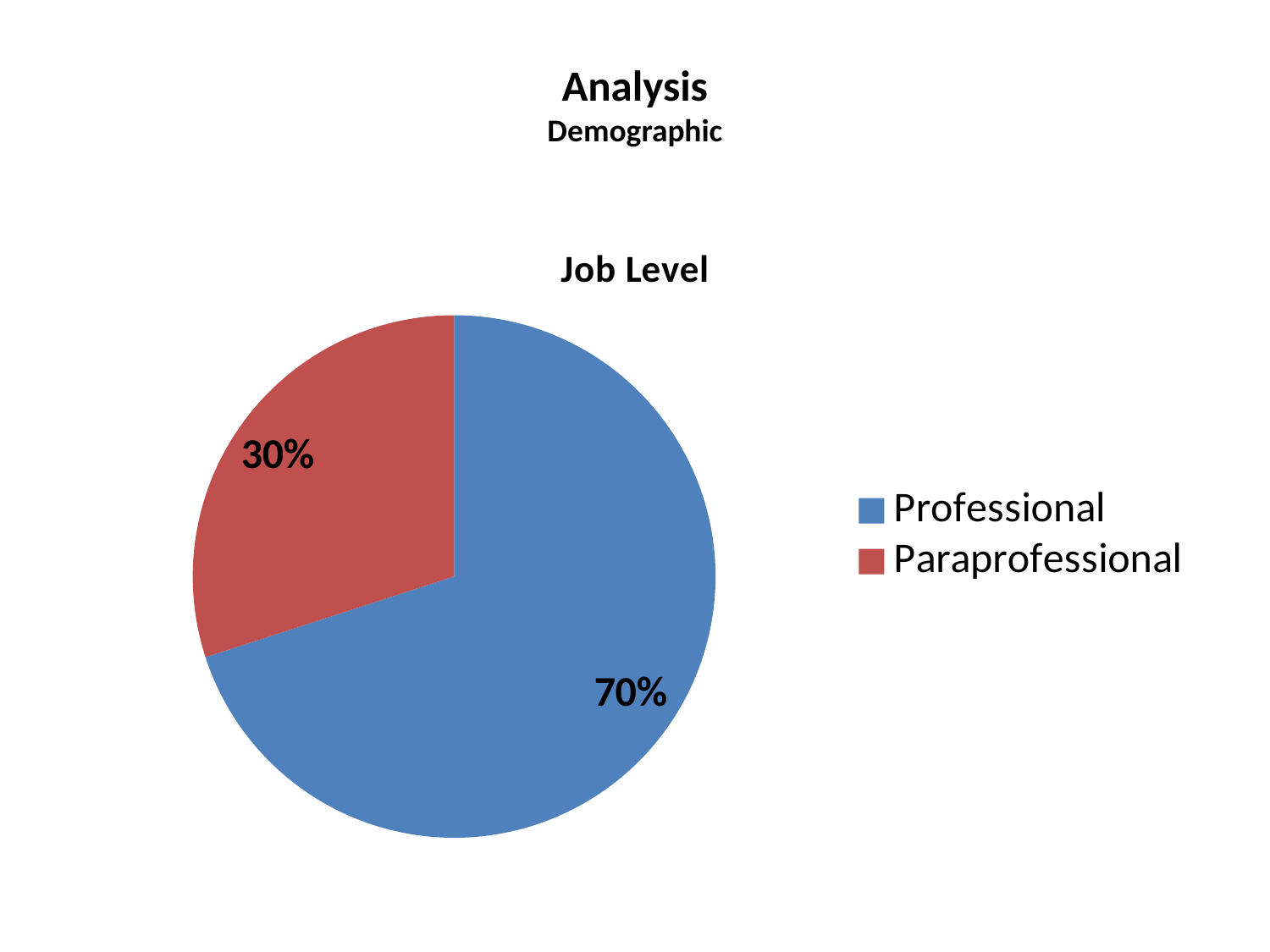
What colour is the Paraprofessional slice? red Which is larger, the Professional slice or the Paraprofessional slice? Professional How many categories does the pie chart show? 2 Which category has the smallest slice of the pie? Paraprofessional What type of chart is shown on the slide? pie chart What share of the pie is Professional? 70% What share of the pie is Paraprofessional? 30% How many entries does the legend list? 2 Which category has the largest slice of the pie? Professional What is the title of the chart? Job Level What is the difference between the Professional and Paraprofessional shares? 40%